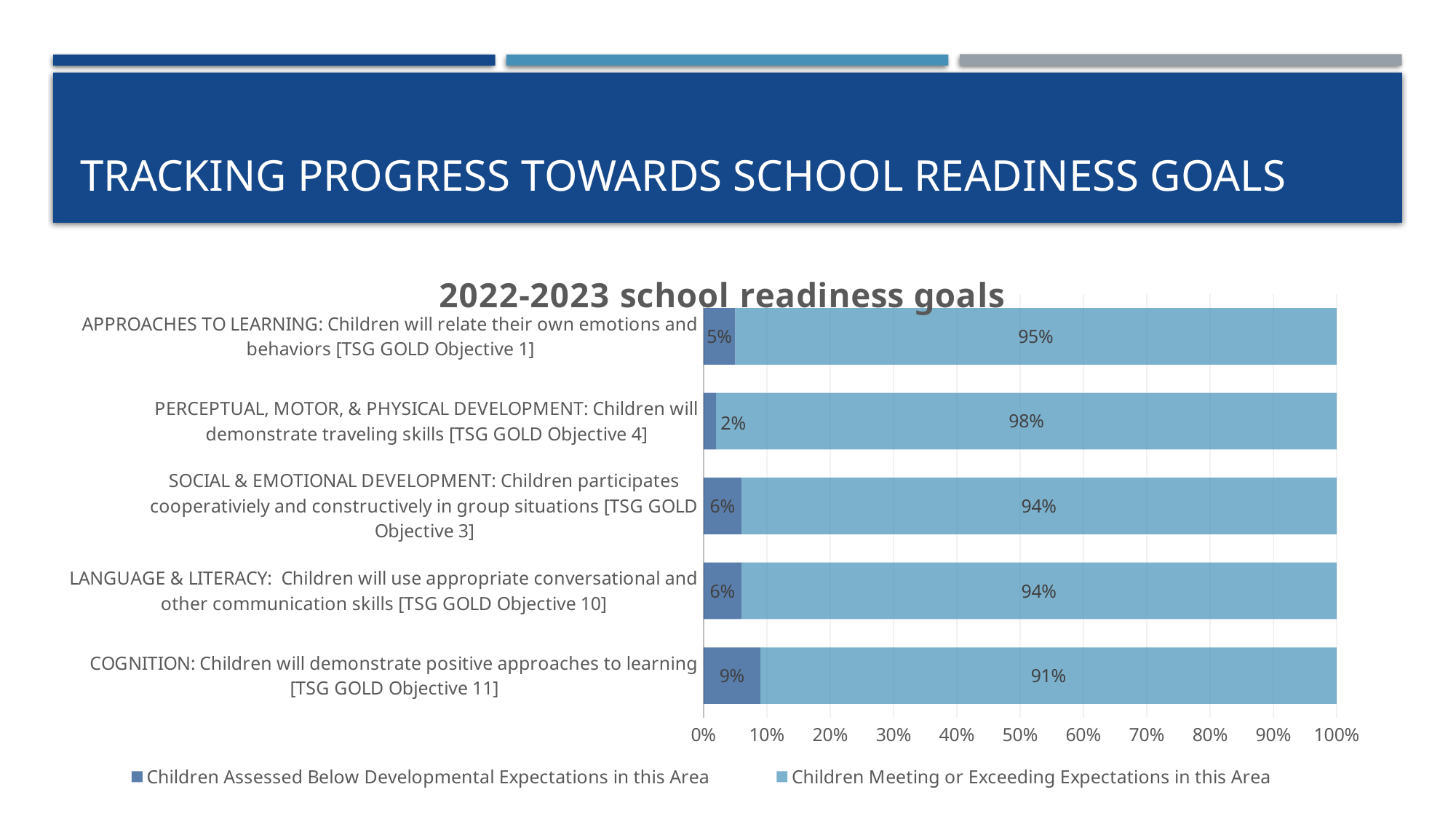
Which area has the lowest percentage of children meeting or exceeding expectations? Cognition What is the difference between the percentage of children meeting or exceeding expectations in Perceptual, Motor, & Physical Development and in Cognition? 7% What type of chart is shown on the slide? Stacked bar chart How many series does the legend list? 2 What is the title of the chart? 2022-2023 school readiness goals What percentage of children are meeting or exceeding expectations in Perceptual, Motor, & Physical Development? 98% Which is larger: the percentage of children below expectations in Social & Emotional Development or in Perceptual, Motor, & Physical Development? Social & Emotional Development How many school readiness goal areas are shown in the chart? 5 Which area has the highest percentage of children meeting or exceeding expectations? Perceptual, Motor, & Physical Development What percentage of children were assessed below developmental expectations in Cognition? 9% Which area has the highest percentage of children assessed below developmental expectations? Cognition What percentage of children are meeting or exceeding expectations in Approaches to Learning? 95%